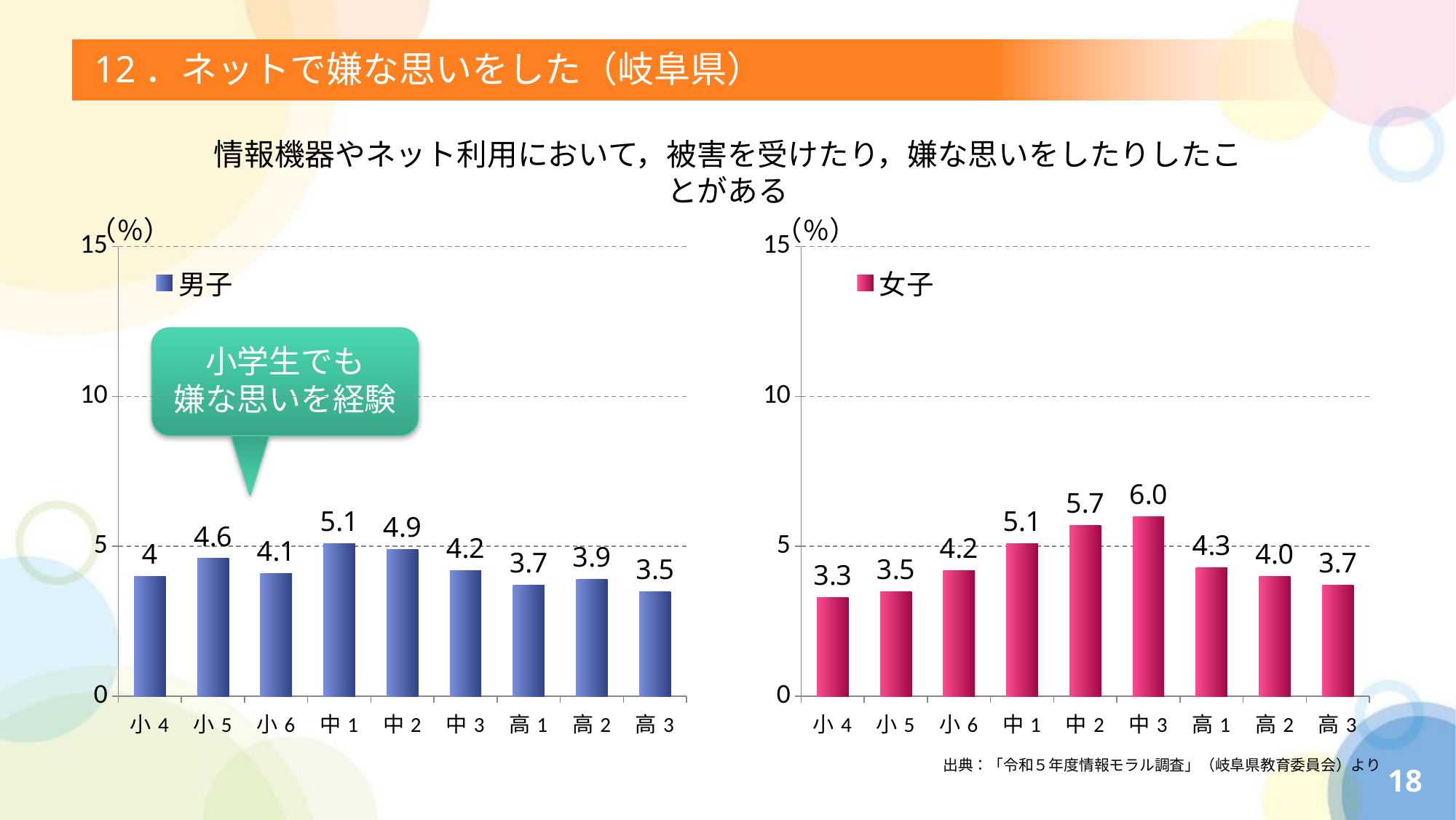
In the left chart (男子), what is the difference between the values for 中1 and 高3? 1.6 In the left chart (男子), what is the value for 中1? 5.1 What series name does the legend of the left chart show? 男子 In the right chart (女子), which category has the lowest value? 小4 In the right chart (女子), what is the value for 中3? 6.0 What kind of chart is the right chart (女子)? bar chart How many categories are shown on the x axis of the left chart (男子)? 9 In the left chart (男子), which is larger, the value for 小5 or the value for 小6? 小5 In the left chart (男子), which category has the lowest value? 高3 In the right chart (女子), what is the difference between the values for 中3 and 小4? 2.7 In the right chart (女子), which category has the highest value? 中3 In the right chart (女子), is the value for 中3 greater or less than 5? greater